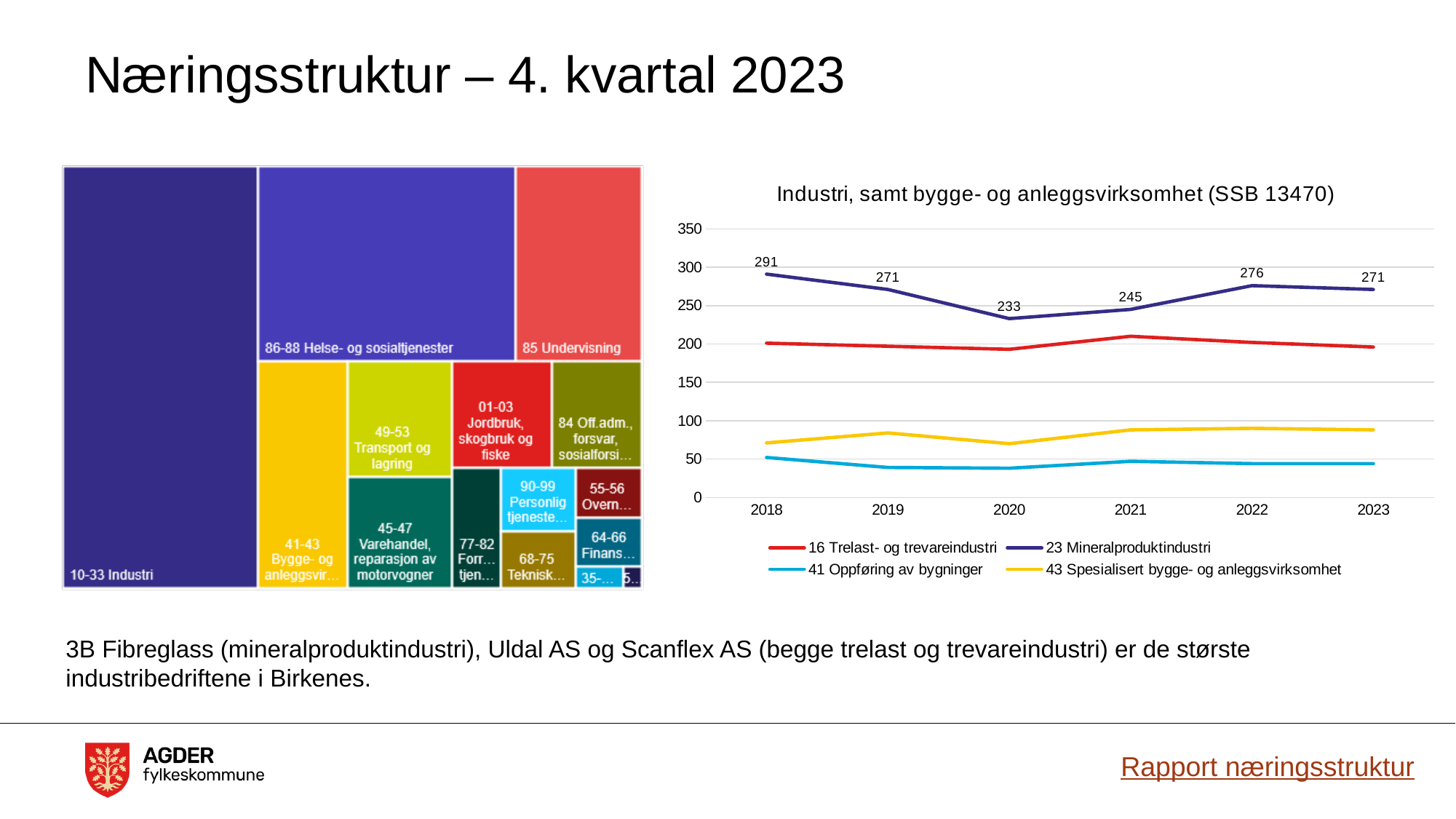
In the treemap chart on the left of the slide, which category occupies the largest area? 10-33 Industri How many series does the legend of the line chart titled "Industri, samt bygge- og anleggsvirksomhet (SSB 13470)" list? 4 In the line chart titled "Industri, samt bygge- og anleggsvirksomhet (SSB 13470)", what is the value for 23 Mineralproduktindustri in 2018? 291 In the line chart titled "Industri, samt bygge- og anleggsvirksomhet (SSB 13470)", is the value for 41 Oppføring av bygninger in 2020 greater or less than 50? less In the line chart titled "Industri, samt bygge- og anleggsvirksomhet (SSB 13470)", what is the value for 23 Mineralproduktindustri in 2022? 276 In the line chart titled "Industri, samt bygge- og anleggsvirksomhet (SSB 13470)", what is the difference between the 2018 and 2020 values for 23 Mineralproduktindustri? 58 In the line chart titled "Industri, samt bygge- og anleggsvirksomhet (SSB 13470)", which series has the higher value in 2023: 43 Spesialisert bygge- og anleggsvirksomhet or 41 Oppføring av bygninger? 43 Spesialisert bygge- og anleggsvirksomhet In the line chart titled "Industri, samt bygge- og anleggsvirksomhet (SSB 13470)", what is the value for 23 Mineralproduktindustri in 2020? 233 In the line chart titled "Industri, samt bygge- og anleggsvirksomhet (SSB 13470)", is the value for 16 Trelast- og trevareindustri in 2021 greater or less than 200? greater How many years are shown on the x axis of the line chart titled "Industri, samt bygge- og anleggsvirksomhet (SSB 13470)"? 6 In the line chart titled "Industri, samt bygge- og anleggsvirksomhet (SSB 13470)", in which year is 23 Mineralproduktindustri lowest? 2020 In the line chart titled "Industri, samt bygge- og anleggsvirksomhet (SSB 13470)", in which year is 23 Mineralproduktindustri highest? 2018